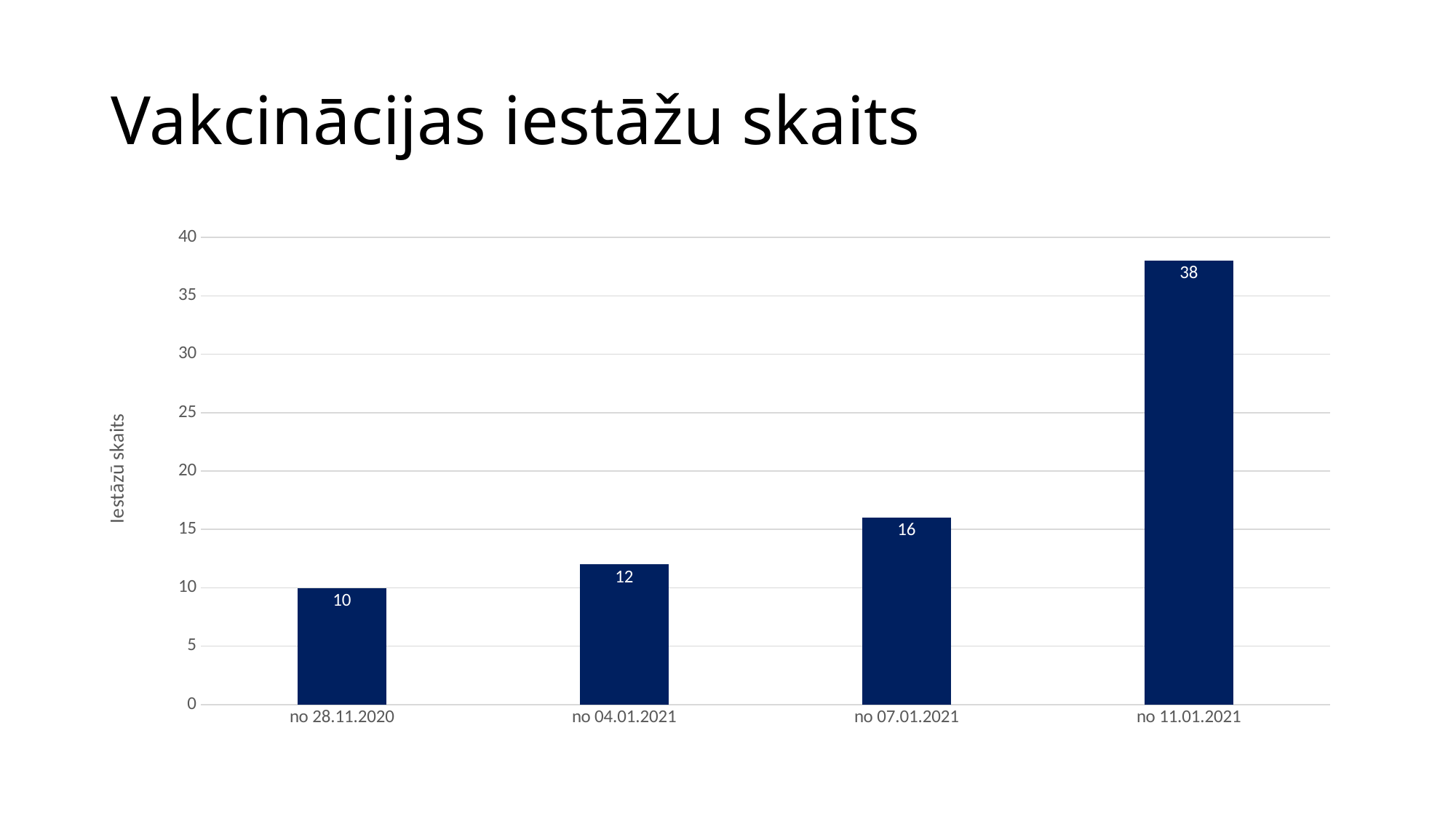
What is the value for no 28.11.2020? 10 How many categories are shown on the x axis? 4 Which category has the lowest value? no 28.11.2020 Is the value for no 11.01.2021 greater or less than 35? greater What is the value for no 11.01.2021? 38 What is the difference between the values for no 11.01.2021 and no 07.01.2021? 22 Which category has the highest value? no 11.01.2021 What is the value for no 07.01.2021? 16 What kind of chart is shown on the slide? bar chart Do the values rise or fall from left to right along the x axis? rise Which is larger, the value for no 04.01.2021 or the value for no 07.01.2021? no 07.01.2021 What is the value for no 04.01.2021? 12